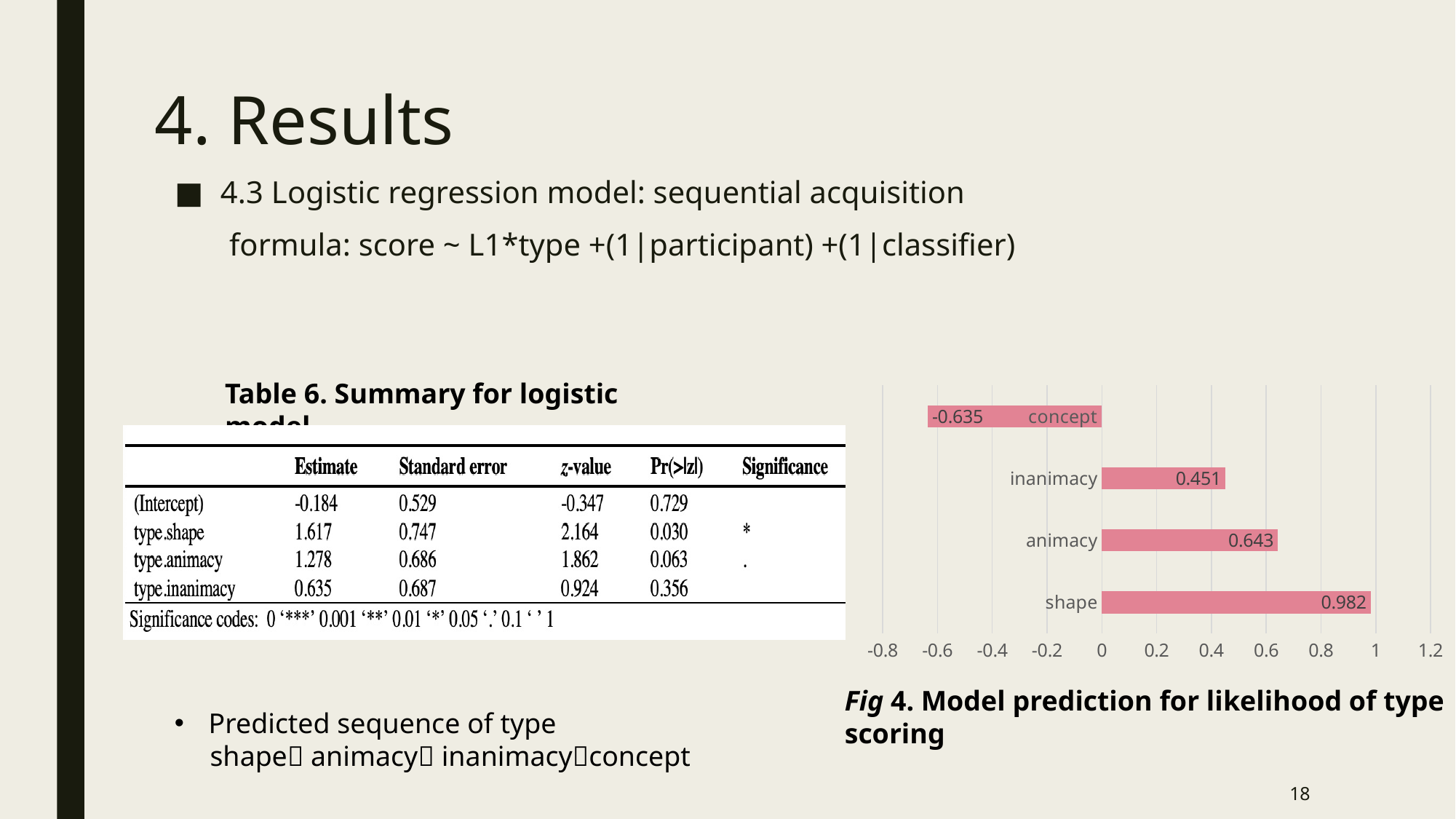
What is the difference between the values for animacy and inanimacy? 0.192 What kind of chart is shown on the slide? bar chart Which category has the lowest value in the chart? concept What is the value for shape in the chart? 0.982 What is the difference between the values for shape and animacy? 0.339 Which is larger, the value for inanimacy or the value for animacy? animacy What is the value for concept in the chart? -0.635 What is the value for inanimacy in the chart? 0.451 What is the value for animacy in the chart? 0.643 Is the value for shape greater or less than 0.8? greater Which category has the highest value in the chart? shape How many categories are shown in the chart? 4